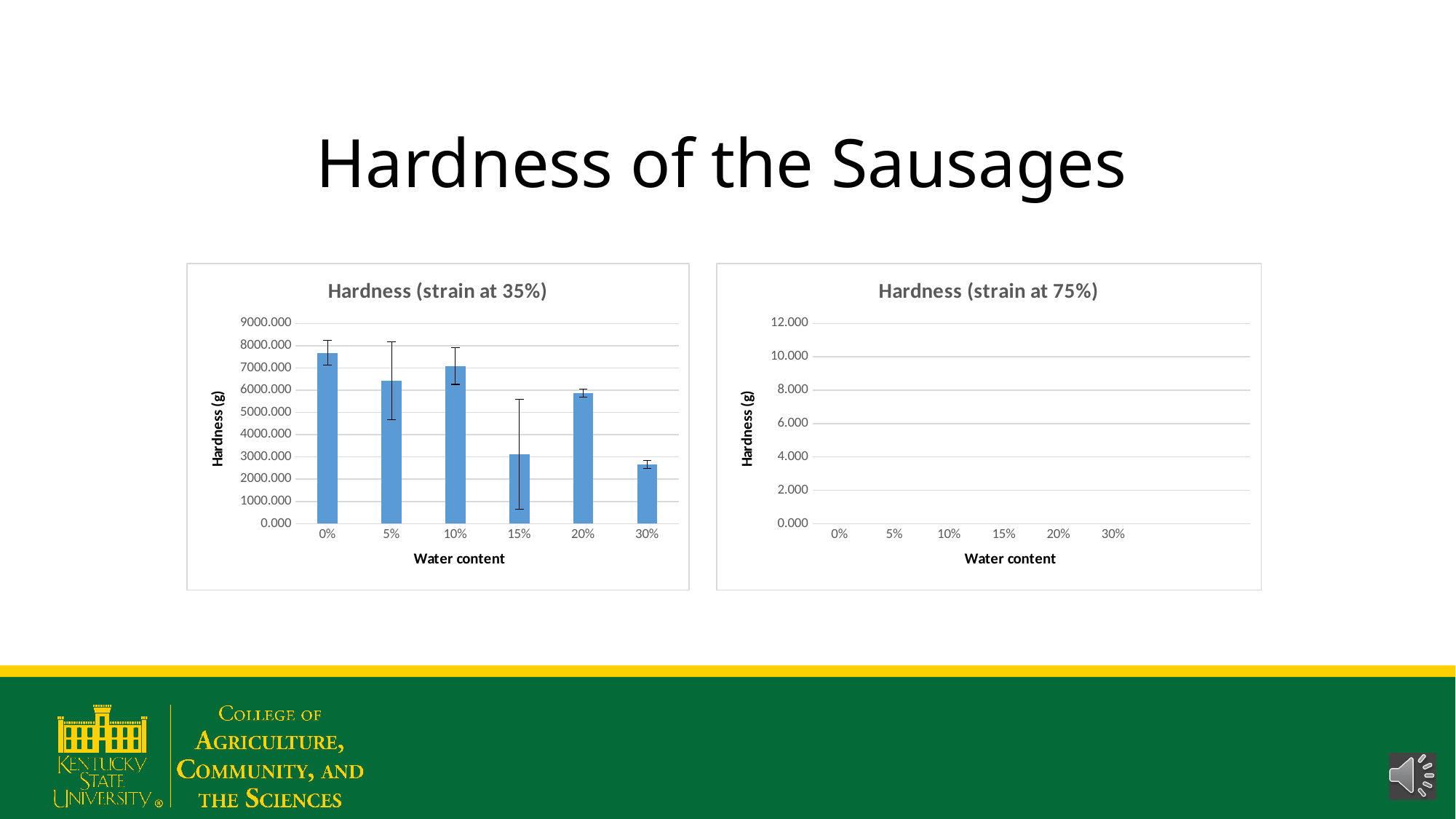
In the 'Hardness (strain at 35%)' chart, is the value for 0% water content greater or less than 7000.000? greater In the 'Hardness (strain at 35%)' chart, is the value for 15% water content greater or less than 4000.000? less In the 'Hardness (strain at 35%)' chart, which water content has the highest hardness? 0% In the 'Hardness (strain at 35%)' chart, is the value for 30% water content greater or less than 3000.000? less How many water content categories are shown on the x axis of the 'Hardness (strain at 35%)' chart? 6 What is the x-axis label of the 'Hardness (strain at 35%)' chart? Water content What is the y-axis label of the 'Hardness (strain at 75%)' chart? Hardness (g) In the 'Hardness (strain at 35%)' chart, which is larger, the hardness at 20% or at 30% water content? 20% What kind of chart is the 'Hardness (strain at 35%)' chart? bar chart In the 'Hardness (strain at 35%)' chart, which is larger, the hardness at 10% or at 15% water content? 10% In the 'Hardness (strain at 35%)' chart, which water content has the lowest hardness? 30%